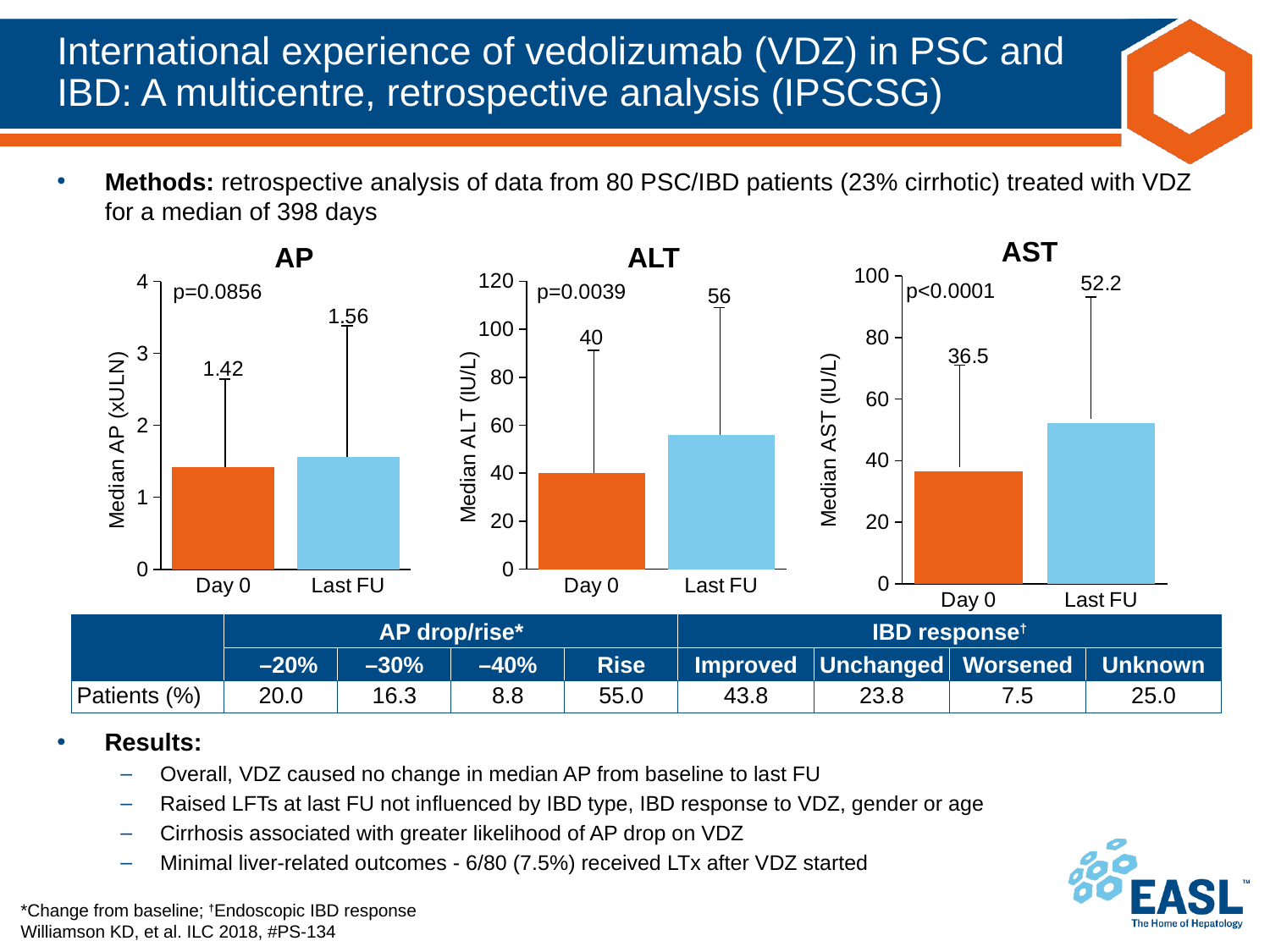
In the AST chart, what is the difference in median AST between Last FU and Day 0? 15.7 In the ALT chart, is the median ALT at Last FU greater or less than 40? greater In the AST chart, do the values rise or fall from Day 0 to Last FU? rise In the AP chart, what is the median AP at Day 0? 1.42 In the ALT chart, what is the difference in median ALT between Last FU and Day 0? 16 In the AP chart, what is the median AP at Last FU? 1.56 What p-value is shown on the ALT chart? p=0.0039 In the AST chart, what is the median AST at Day 0? 36.5 In the AST chart, which time point has the higher median AST, Day 0 or Last FU? Last FU In the AP chart, how many bars are plotted? 2 In the ALT chart, what is the median ALT at Last FU? 56 What type of chart is the ALT chart? bar chart